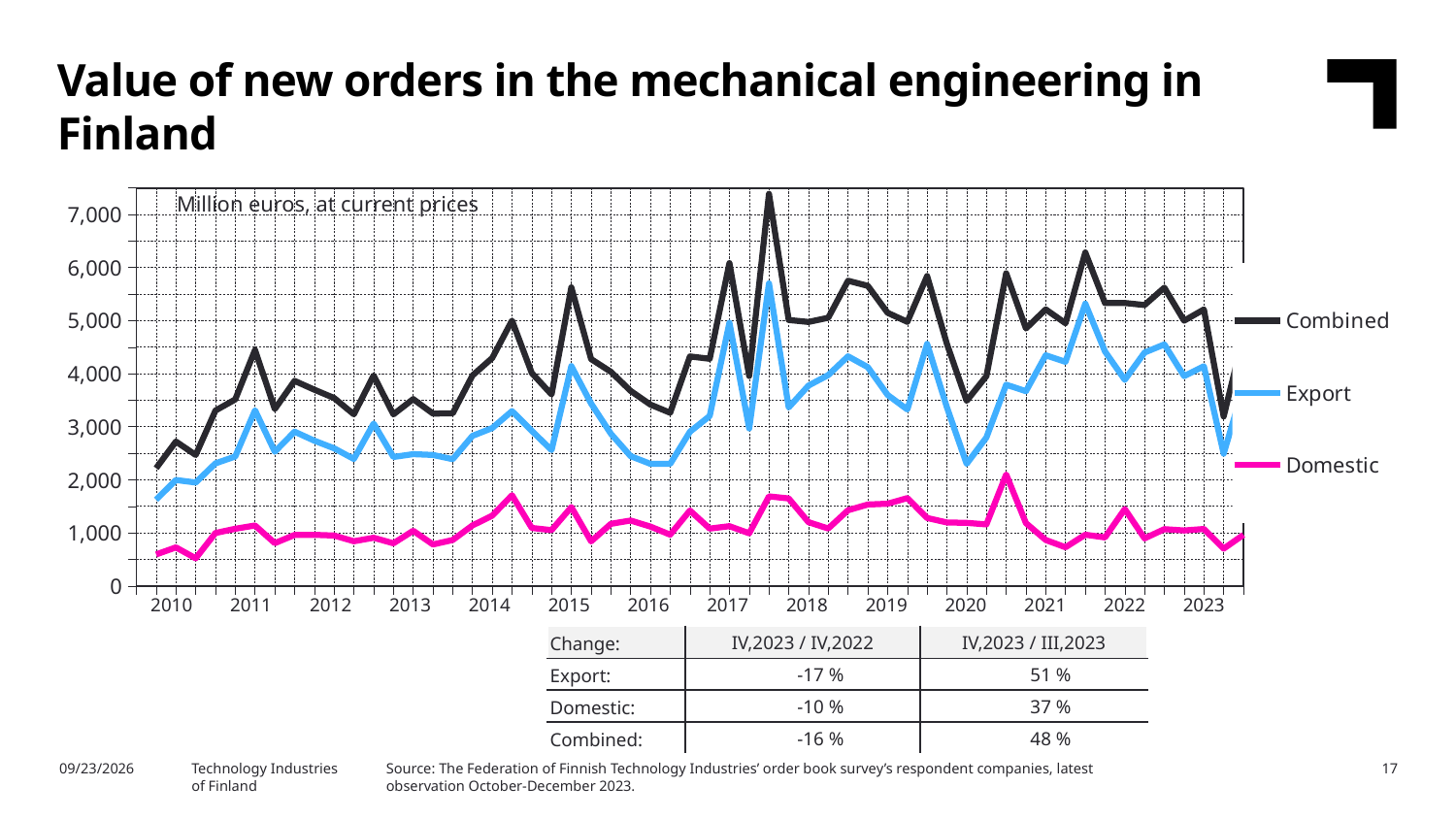
Which series has the lowest values throughout the chart? Domestic Does the Combined series rise or fall from the start of 2010 to the start of 2011? Rise Which series has the highest values throughout the chart? Combined What kind of chart is shown on the slide? Line chart How many year labels are shown on the x axis? 14 Is the first value of the Export series in 2010 greater or less than 2,000? less Which is larger at the start of 2010, the Combined value or the Export value? Combined How many series does the legend list? 3 What are the three series named in the legend? Combined, Export, Domestic Is the peak value of the Combined series in 2017 greater or less than 7,000? greater What unit is stated in the chart's subtitle? Million euros, at current prices Is the first value of the Domestic series in 2010 greater or less than 1,000? less